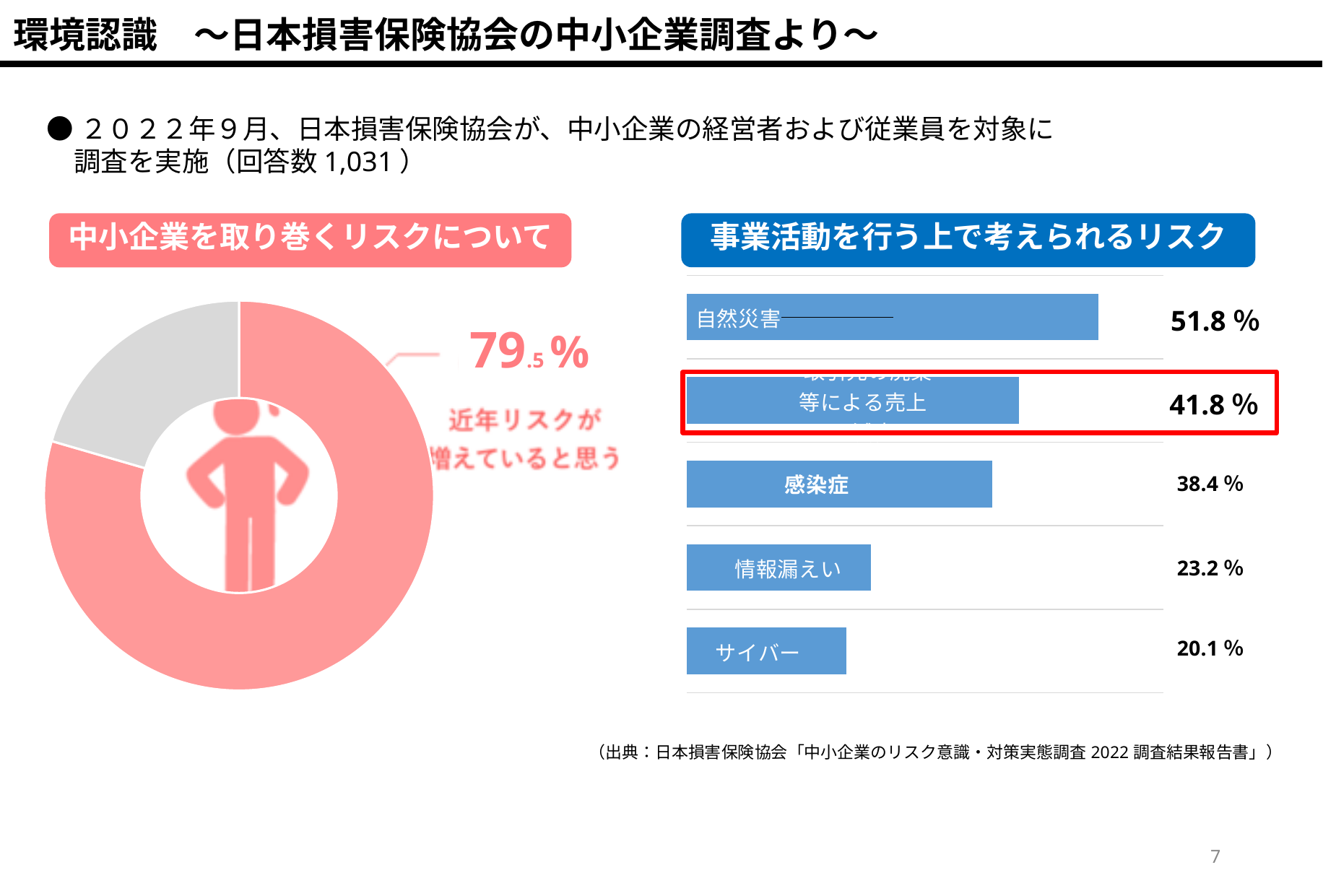
In the bar chart titled 事業活動を行う上で考えられるリスク, what is the value of the bar outlined in red? 41.8 % What kind of chart is the chart on the left titled 中小企業を取り巻くリスクについて? Donut (pie) chart In the bar chart titled 事業活動を行う上で考えられるリスク, what is the value for 自然災害? 51.8 % How many categories are shown in the bar chart titled 事業活動を行う上で考えられるリスク? 5 In the bar chart titled 事業活動を行う上で考えられるリスク, which is larger, the value for 情報漏えい or the value for サイバー? 情報漏えい In the bar chart titled 事業活動を行う上で考えられるリスク, which category has the highest value? 自然災害 In the bar chart titled 事業活動を行う上で考えられるリスク, what is the value for 情報漏えい? 23.2 % In the bar chart titled 事業活動を行う上で考えられるリスク, what is the difference between the values for 自然災害 and 感染症? 13.4 % In the bar chart titled 事業活動を行う上で考えられるリスク, what is the value for サイバー? 20.1 % In the bar chart titled 事業活動を行う上で考えられるリスク, which category has the lowest value? サイバー In the bar chart titled 事業活動を行う上で考えられるリスク, what is the value for 感染症? 38.4 % In the donut chart titled 中小企業を取り巻くリスクについて, what percentage is shown for 近年リスクが増えていると思う? 79.5 %